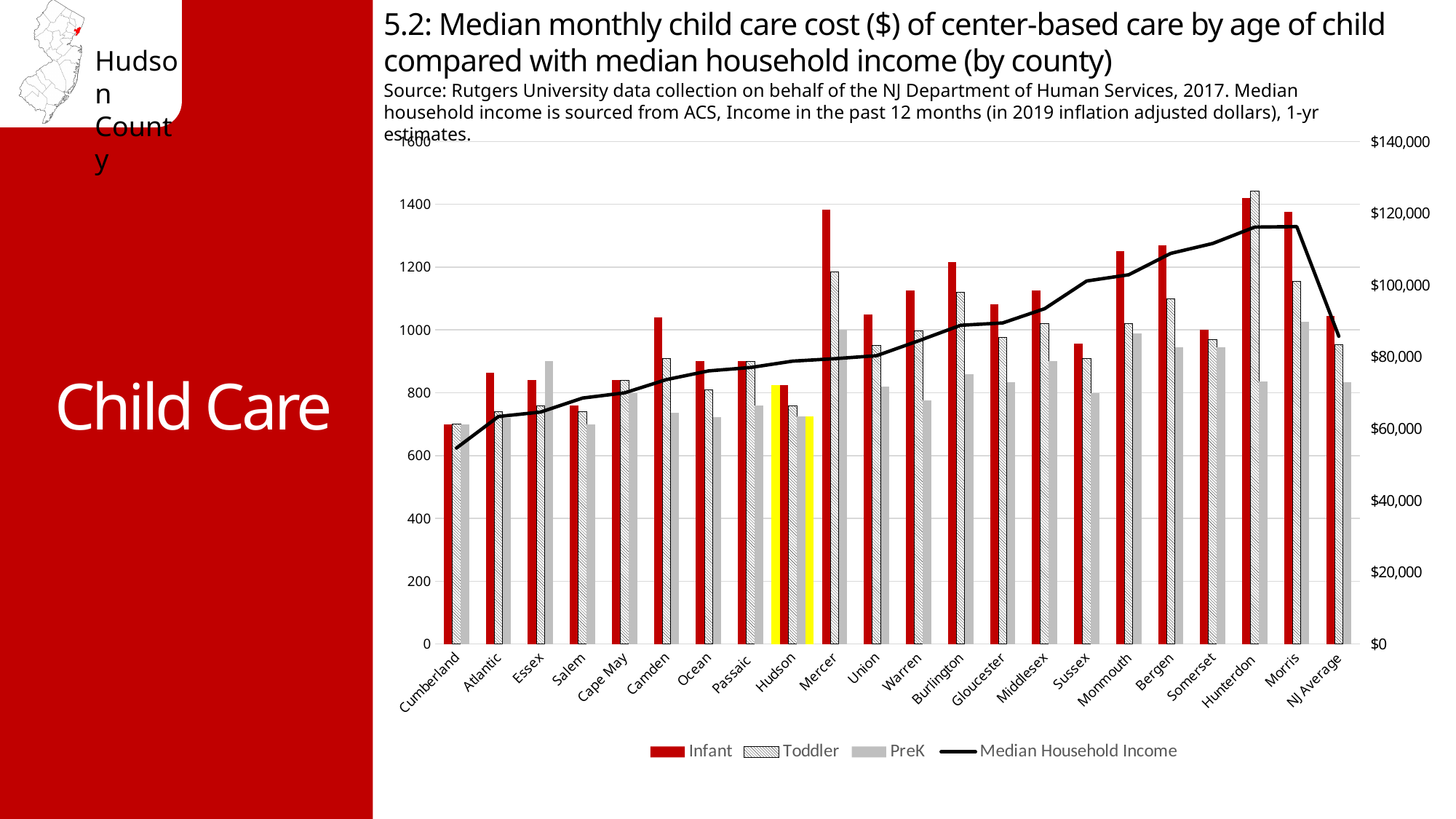
Does the Median Household Income line generally rise or fall from Cumberland to Morris? rise Which is larger, the Infant value for Mercer or the Infant value for Hudson? Mercer Is the Median Household Income for Morris greater or less than $100,000? greater Which county has the highest Infant bar? Hunterdon Is the Infant value for Mercer greater or less than 1200? greater Which county has the highest Toddler bar? Hunterdon What kind of chart is this? Bar chart with a line series Is the Infant value for Hudson greater or less than 1000? less Which county has the lowest Infant bar? Cumberland How many counties/categories are shown along the x axis? 22 How many series does the legend list? 4 Which county's bars are highlighted in yellow? Hudson